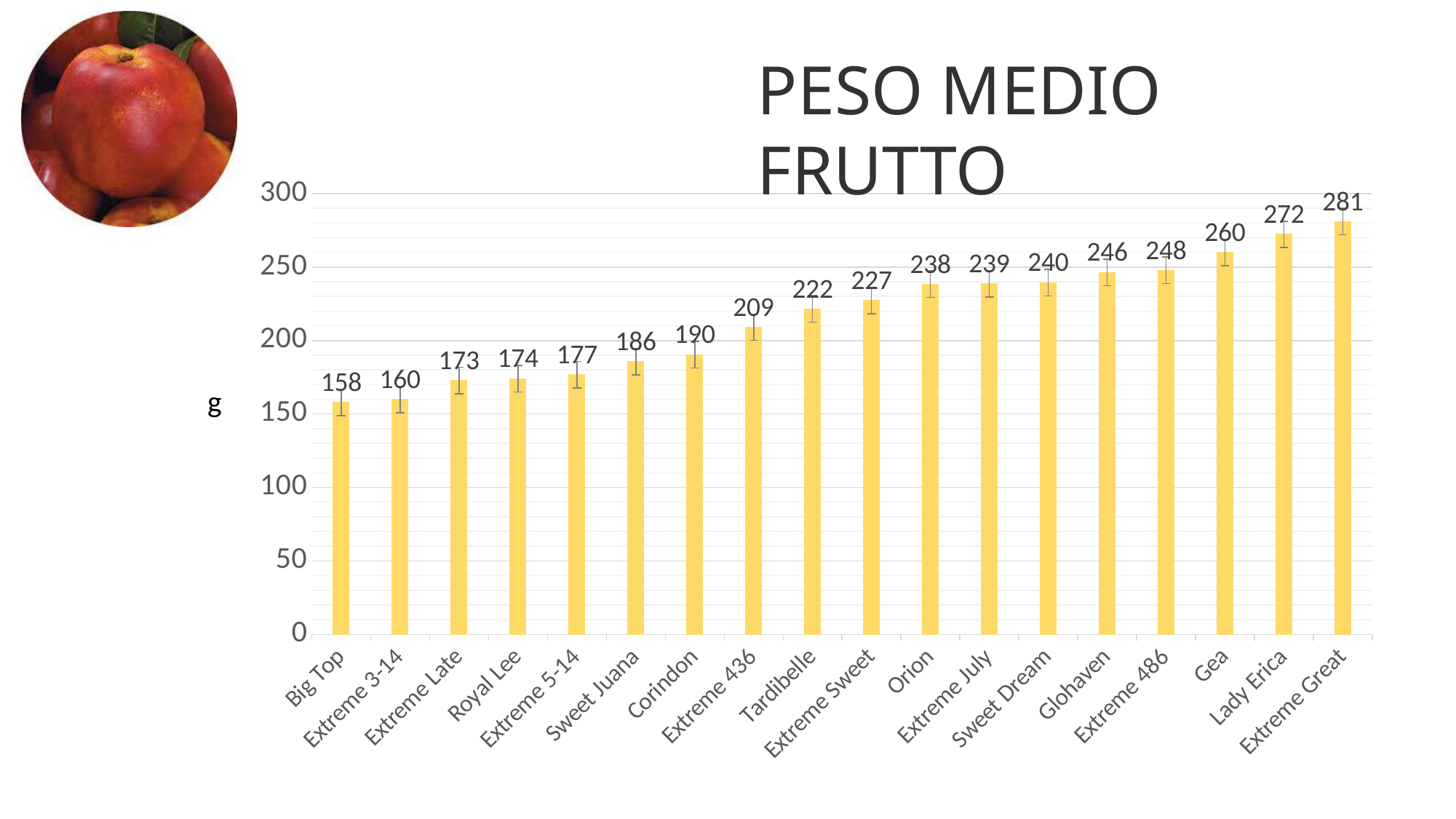
What is the value for Extreme Sweet? 227 What kind of chart is shown on the slide? bar chart What is the value for Lady Erica? 272 Which is larger, the value for Tardibelle or the value for Sweet Juana? Tardibelle How many categories are shown on the x axis? 18 What is the value for Corindon? 190 Which category has the highest value? Extreme Great What is the difference between the values for Gea and Glohaven? 14 What is the difference between the values for Extreme Great and Big Top? 123 Do the values rise or fall from left to right along the x axis? rise Is the value for Orion greater or less than 200? greater Which category has the lowest value? Big Top